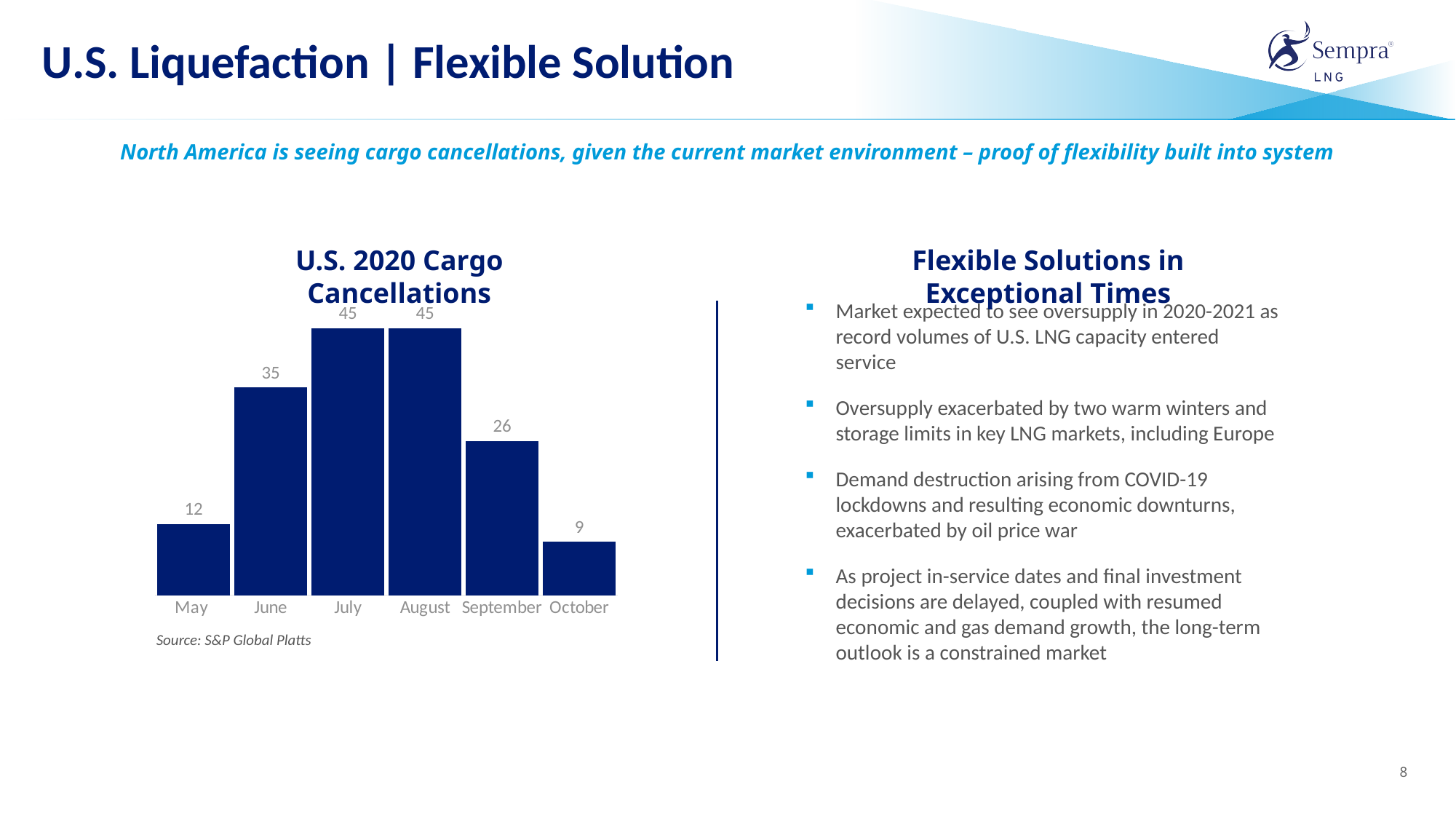
What is the highest value shown in the U.S. 2020 Cargo Cancellations chart? 45 What is the difference between the values for August and September in the U.S. 2020 Cargo Cancellations chart? 19 Which is larger in the U.S. 2020 Cargo Cancellations chart, the value for June or the value for September? June What kind of chart is the U.S. 2020 Cargo Cancellations chart? Bar chart What is the value for September in the U.S. 2020 Cargo Cancellations chart? 26 What is the source cited below the U.S. 2020 Cargo Cancellations chart? S&P Global Platts What is the value for June in the U.S. 2020 Cargo Cancellations chart? 35 In the U.S. 2020 Cargo Cancellations chart, do the values rise or fall from August to October? Fall What is the difference between the values for June and May in the U.S. 2020 Cargo Cancellations chart? 23 What is the value for May in the U.S. 2020 Cargo Cancellations chart? 12 Which month has the lowest value in the U.S. 2020 Cargo Cancellations chart? October How many months are shown in the U.S. 2020 Cargo Cancellations chart? 6